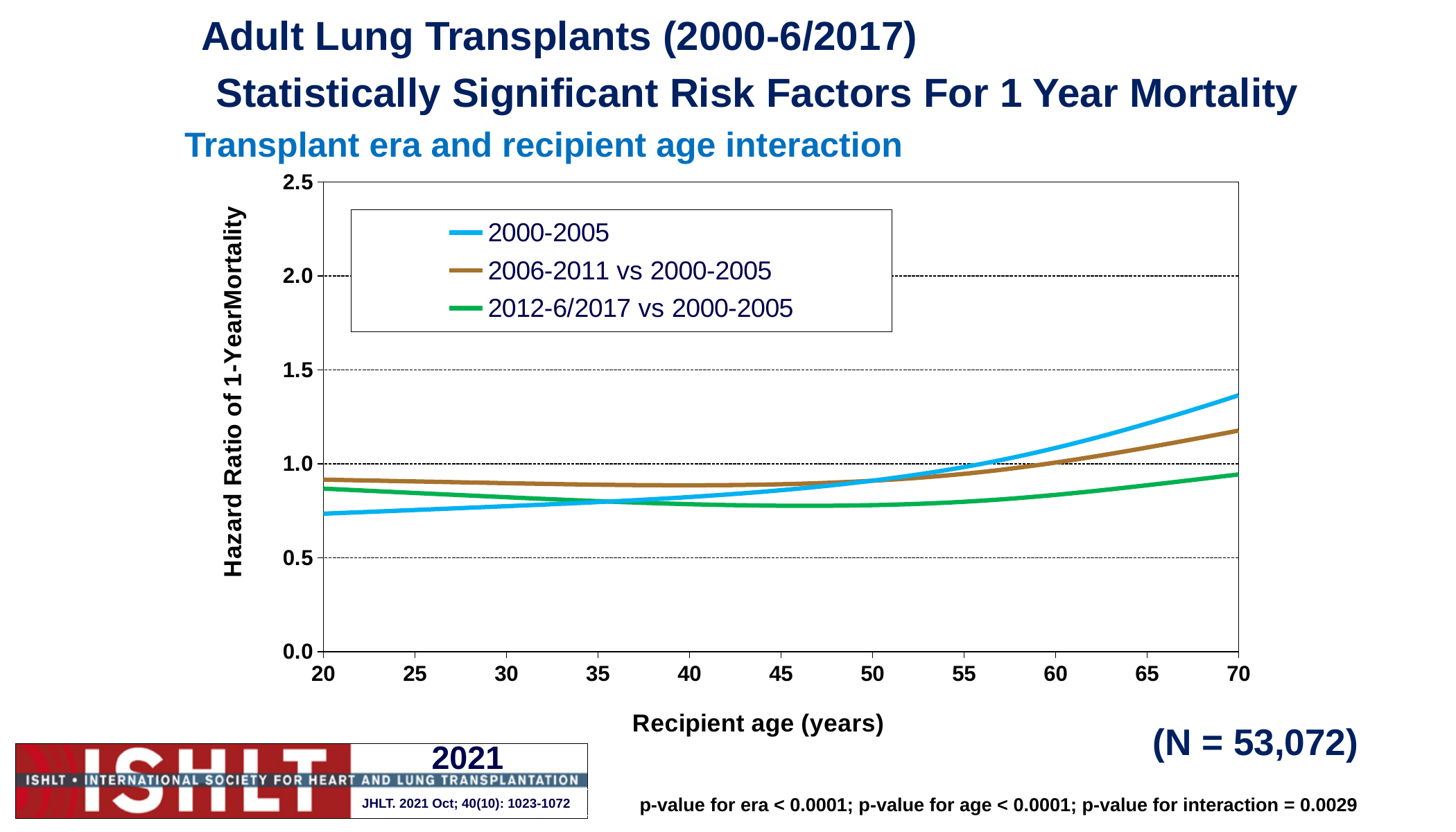
Is the value for the 2006-2011 vs 2000-2005 series at recipient age 70 greater or less than 1.5? less What is the label of the y axis? Hazard Ratio of 1-YearMortality What is the label of the x axis? Recipient age (years) Which series has the lowest value at recipient age 20? 2000-2005 What kind of chart is shown on the slide? line chart Does the 2000-2005 series rise or fall as recipient age increases from 20 to 70? rise Is the value for the 2000-2005 series at recipient age 70 greater or less than 1.0? greater Is the value for the 2012-6/2017 vs 2000-2005 series at recipient age 50 greater or less than 1.0? less How many series does the legend list? 3 At recipient age 20, which is larger: the 2006-2011 vs 2000-2005 series or the 2000-2005 series? 2006-2011 vs 2000-2005 Which series has the highest value at recipient age 70? 2000-2005